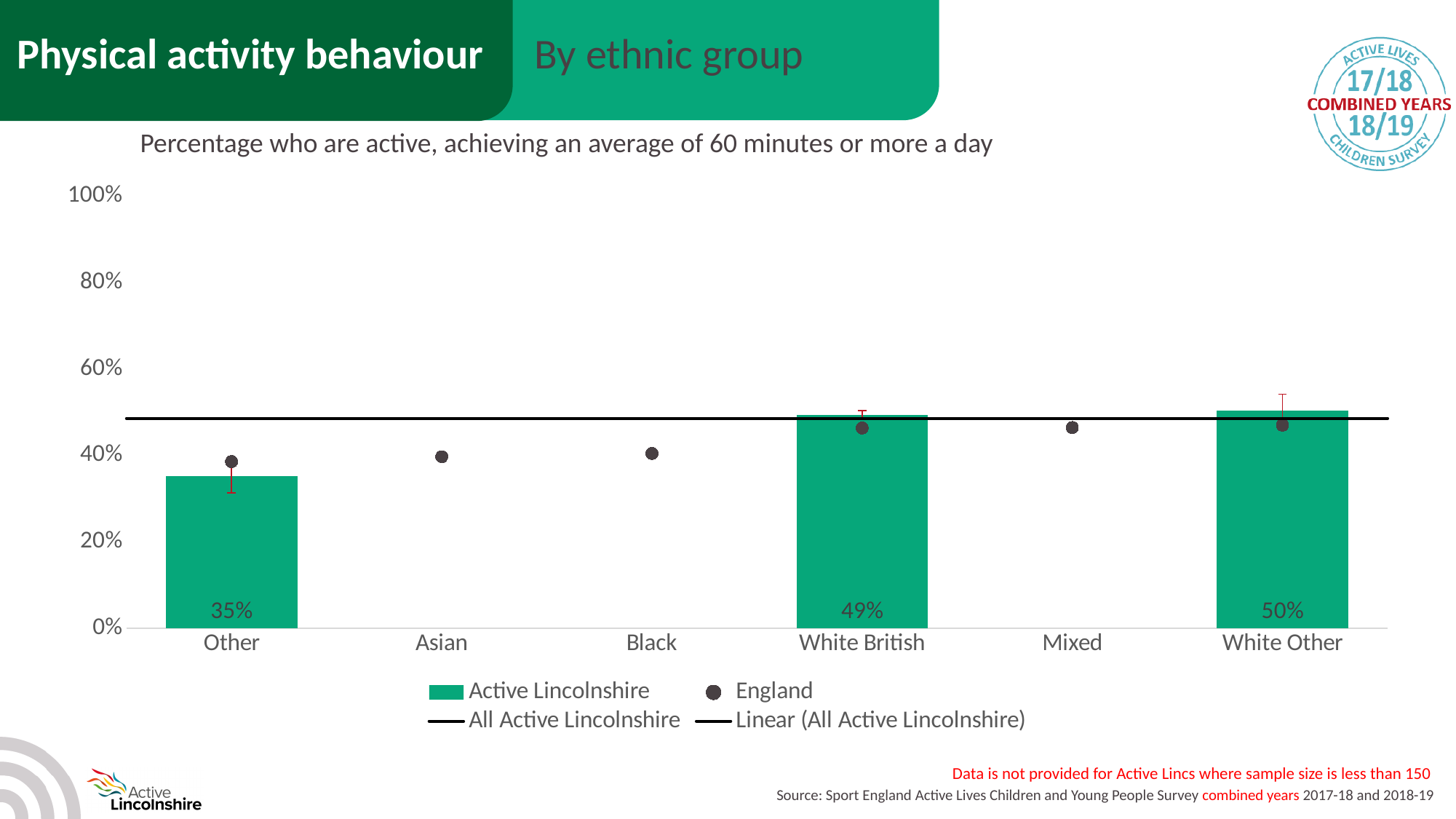
What kind of chart is shown on the slide? Bar chart with dot markers and a line How many ethnic group categories are shown on the x axis? 6 What is the Active Lincolnshire value for the Other ethnic group? 35% Which ethnic group has the highest Active Lincolnshire bar? White Other What is the difference between the Active Lincolnshire values for White Other and Other? 15 percentage points Is the England value for the Mixed ethnic group greater or less than 40%? greater What is the Active Lincolnshire value for White British? 49% What colour are the Active Lincolnshire bars? Green How many entries does the legend list? 4 Which ethnic group has the lowest Active Lincolnshire bar? Other What is the Active Lincolnshire value for White Other? 50% Which is larger, the Active Lincolnshire value for White British or for Other? White British